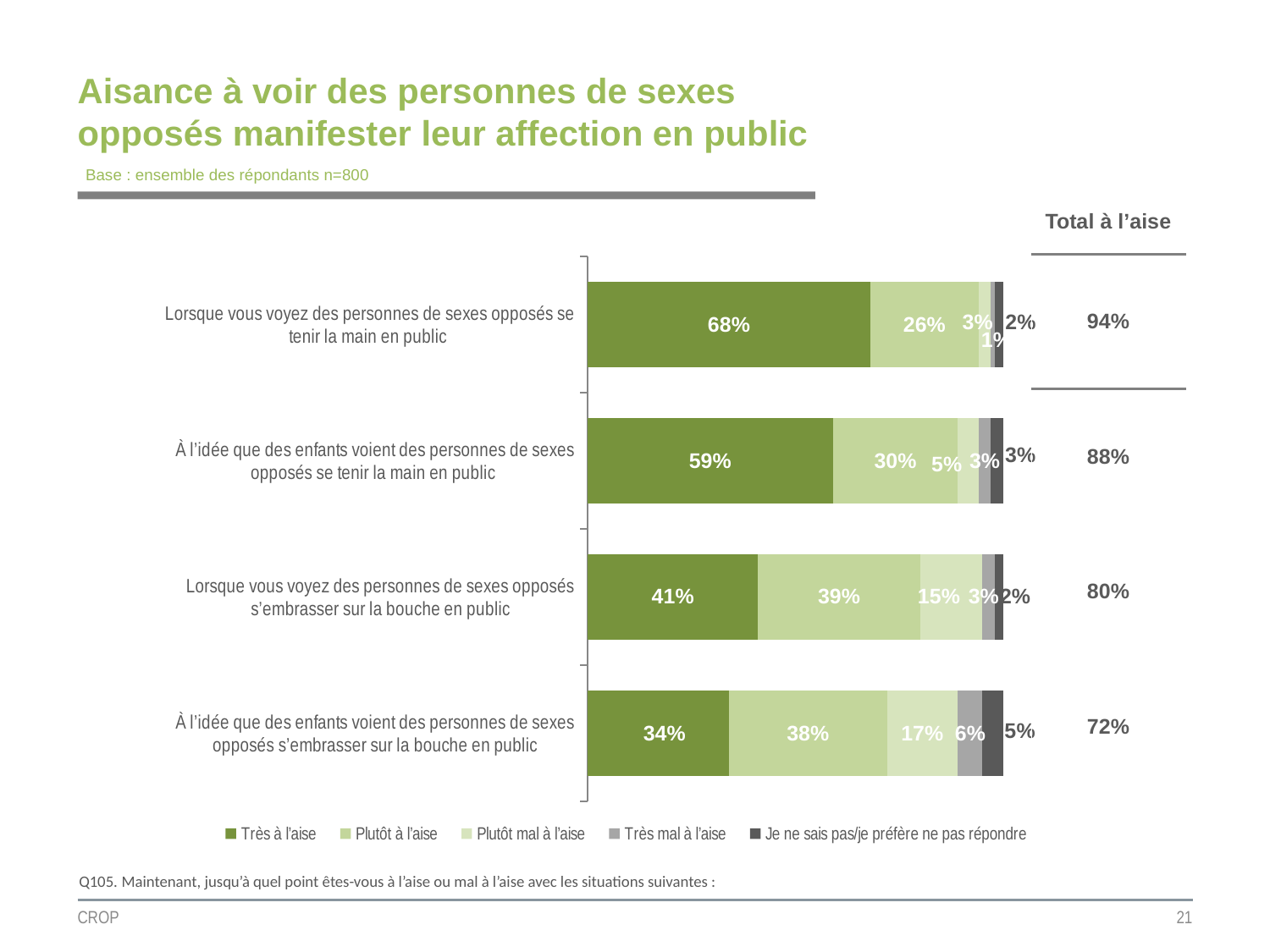
What is the 'Très à l'aise' value for 'Lorsque vous voyez des personnes de sexes opposés se tenir la main en public'? 68% Which situation has the highest 'Très à l'aise' value? Lorsque vous voyez des personnes de sexes opposés se tenir la main en public Which situation has the lowest 'Total à l'aise' value? À l'idée que des enfants voient des personnes de sexes opposés s'embrasser sur la bouche en public What is the 'Plutôt mal à l'aise' value for 'Lorsque vous voyez des personnes de sexes opposés s'embrasser sur la bouche en public'? 15% What kind of chart is shown on the slide? Stacked bar chart What is the 'Très mal à l'aise' value for 'À l'idée que des enfants voient des personnes de sexes opposés s'embrasser sur la bouche en public'? 6% What is the 'Plutôt à l'aise' value for 'À l'idée que des enfants voient des personnes de sexes opposés se tenir la main en public'? 30% What is the 'Total à l'aise' value shown for 'Lorsque vous voyez des personnes de sexes opposés s'embrasser sur la bouche en public'? 80% How many categories (situations) are plotted in the chart? 4 How many series does the legend list? 5 What is the difference between the 'Très à l'aise' values for 'Lorsque vous voyez des personnes de sexes opposés se tenir la main en public' and 'À l'idée que des enfants voient des personnes de sexes opposés se tenir la main en public'? 9% Which is larger: the 'Plutôt à l'aise' value for 'Lorsque vous voyez des personnes de sexes opposés s'embrasser sur la bouche en public' or for 'À l'idée que des enfants voient des personnes de sexes opposés s'embrasser sur la bouche en public'? Lorsque vous voyez des personnes de sexes opposés s'embrasser sur la bouche en public